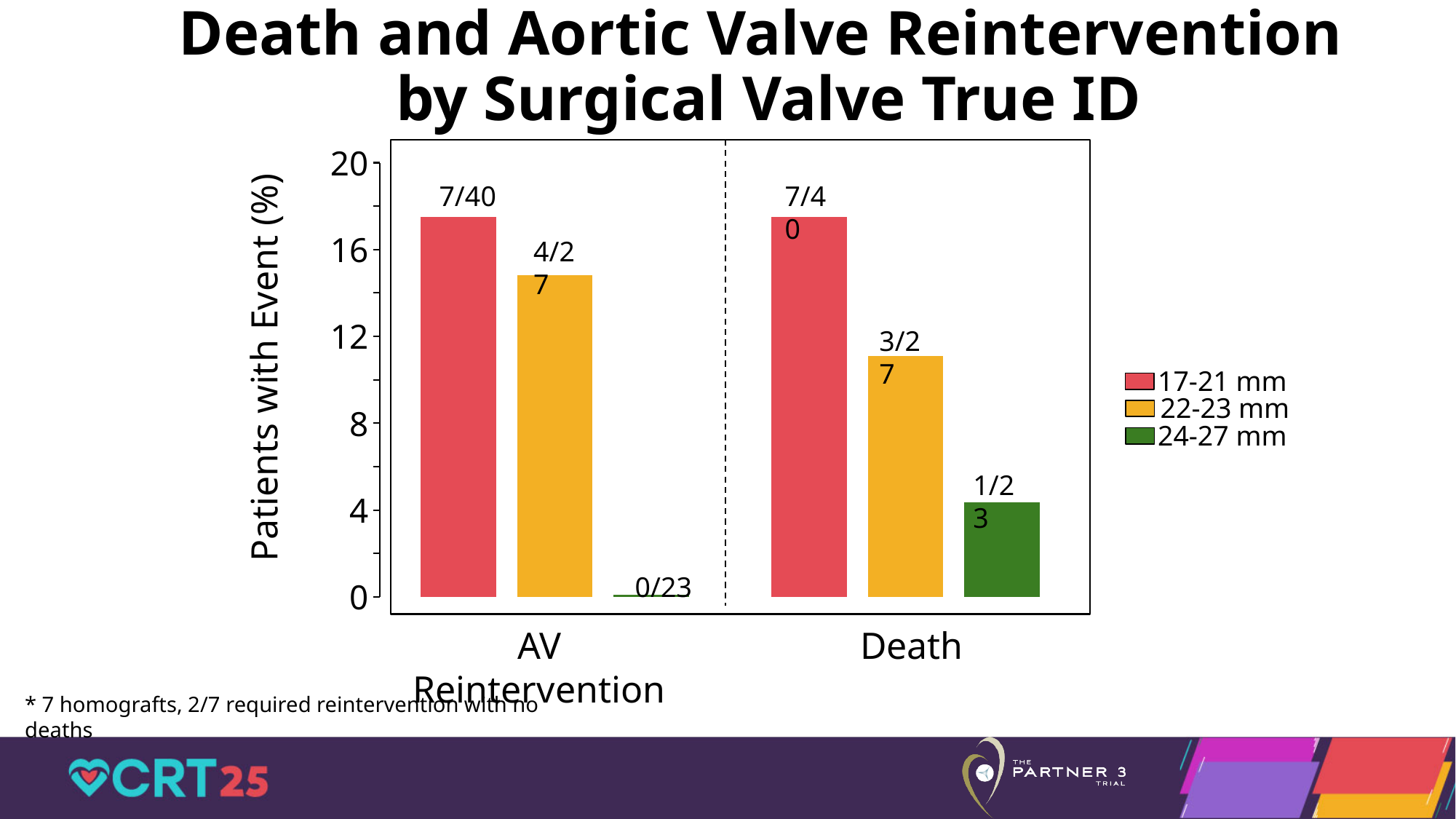
What is the label of the y axis? Patients with Event (%) Which is larger for the 22-23 mm group: the AV Reintervention value or the Death value? AV Reintervention What kind of chart is shown on the slide? bar chart What data label is printed on the 24-27 mm bar for Death? 1/23 What data label is printed on the 17-21 mm bar for AV Reintervention? 7/40 What data label is printed on the 22-23 mm bar for Death? 3/27 Which valve size group has the lowest percentage of patients with AV Reintervention? 24-27 mm Is the value for 22-23 mm in the Death category greater or less than 12? less What data label is printed on the 24-27 mm bar for AV Reintervention? 0/23 Which valve size group has the highest percentage of patients with Death? 17-21 mm Is the value for 17-21 mm in the AV Reintervention category greater or less than 16? greater How many series does the legend list? 3